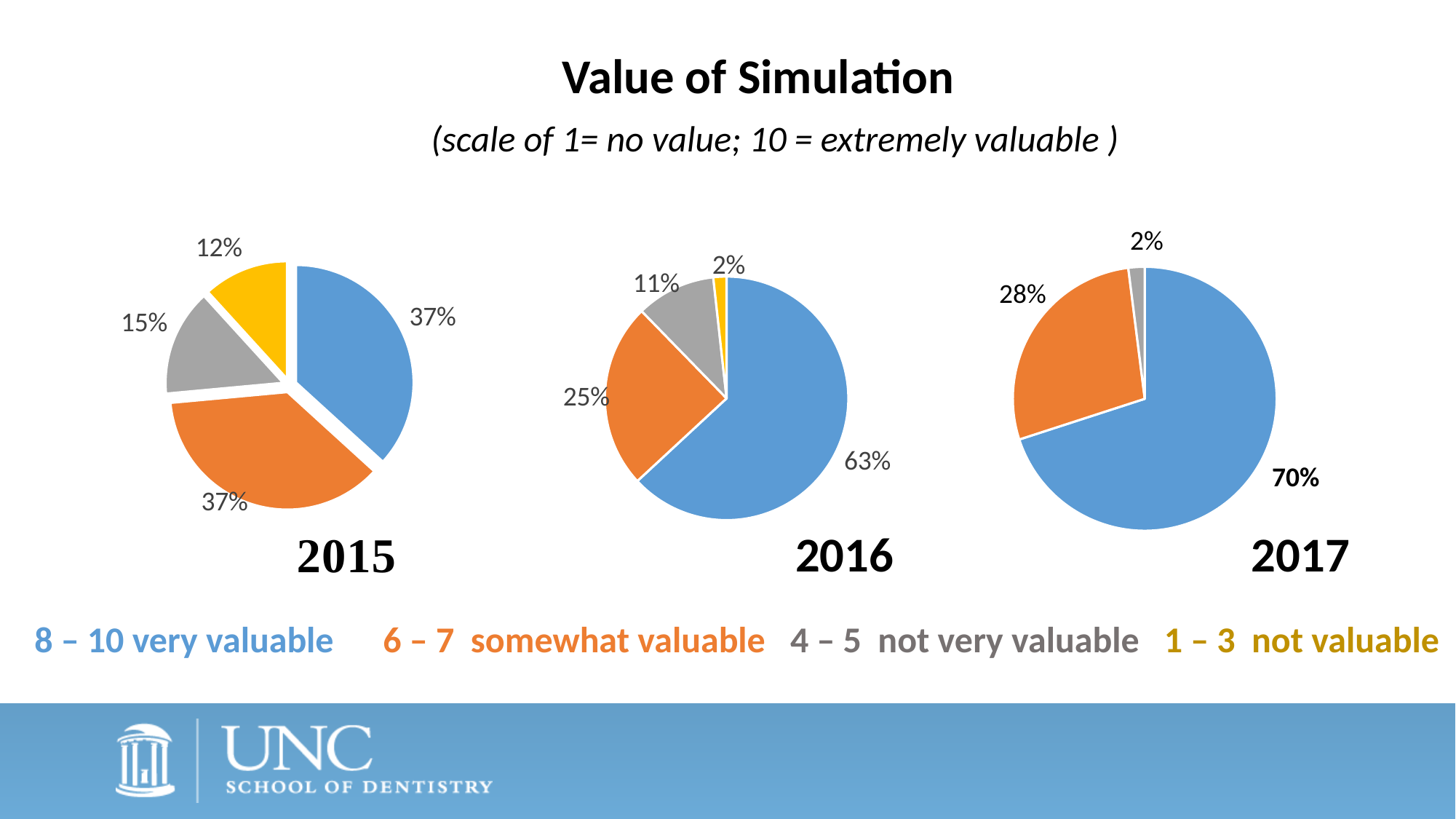
In the 2015 pie chart, what percentage of respondents rated simulation as not very valuable (4 – 5)? 15% What type of charts are shown on the slide? Pie charts In the 2015 pie chart, what percentage of respondents rated simulation as not valuable (1 – 3)? 12% Which colour represents the 6 – 7 somewhat valuable category in the pie charts? Orange In the 2016 pie chart, what percentage of respondents rated simulation as very valuable (8 – 10)? 63% How many slices does the 2017 pie chart have? 3 In the 2017 pie chart, which rating category has the largest share? 8 – 10 very valuable In the 2016 pie chart, what is the difference between the very valuable share and the somewhat valuable share? 38% How does the very valuable (8 – 10) share change from 2015 to 2017 across the three pie charts? It rises In the 2016 pie chart, which rating category has the smallest share? 1 – 3 not valuable In the 2017 pie chart, what percentage of respondents rated simulation as somewhat valuable (6 – 7)? 28% Is the very valuable (8 – 10) share larger in the 2015 pie chart or the 2017 pie chart? 2017